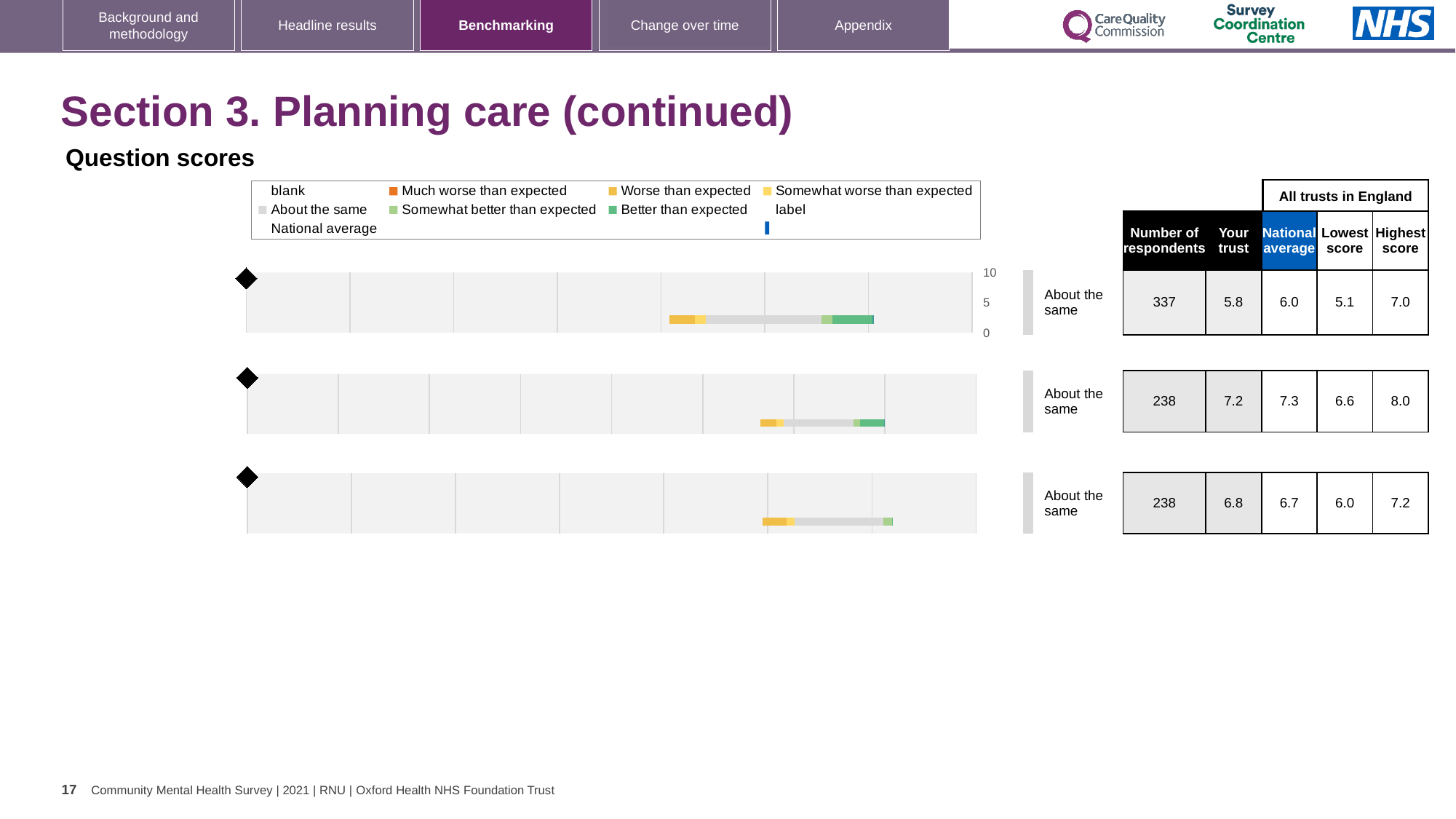
For the top chart, what is the 'Your trust' score shown in the table? 5.8 How many question score charts are shown on the slide? 3 What kind of chart is used to show the question scores on this slide? bar chart For the middle chart, what is the national average score? 7.3 What benchmark category label is shown next to each of the three charts? About the same For the top chart, what is the highest score among all trusts in England? 7.0 What is the maximum value shown on the vertical axis of the top chart? 10 For the middle chart, what is the difference between the highest score and the lowest score? 1.4 For the bottom chart, is the 'Your trust' score higher or lower than the national average? higher For the bottom chart, what is the number of respondents? 238 For the top chart, what is the difference between the national average and the 'Your trust' score? 0.2 Which of the three charts has the highest 'Your trust' score? the middle chart